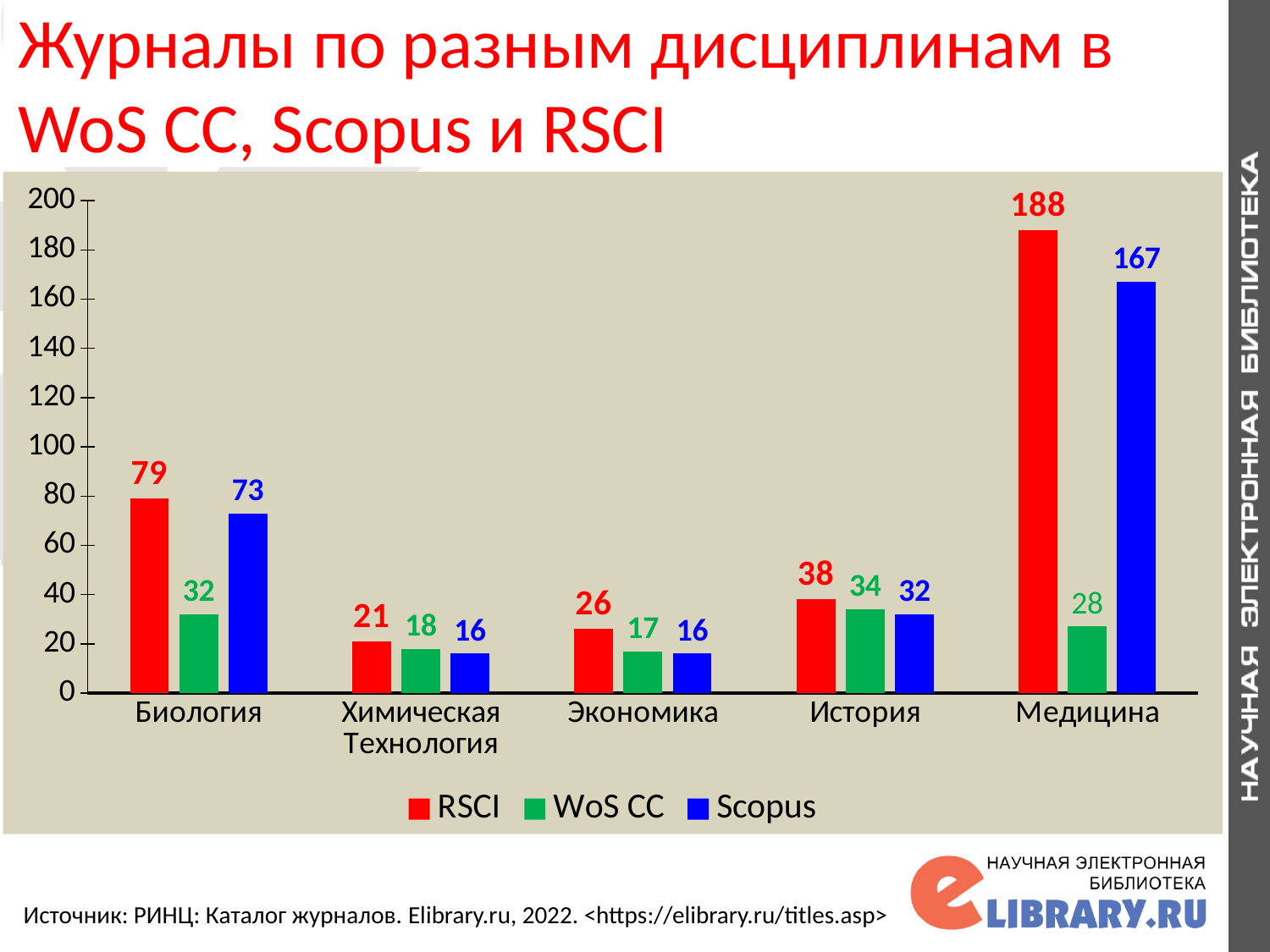
Which category has the highest RSCI value? Медицина How many series does the legend list? 3 What is the WoS CC value for Биология? 32 How many categories are shown on the x axis? 5 Is the Scopus value for Медицина greater or less than 160? greater Which category has the lowest Scopus value? Химическая Технология and Экономика (both 16) What kind of chart is shown on the slide? Bar chart Which colour represents the WoS CC series? Green Which is larger for Биология: the RSCI value or the Scopus value? RSCI What is the Scopus value for История? 32 What is the difference between the RSCI and Scopus values for Медицина? 21 What is the RSCI value for Медицина? 188